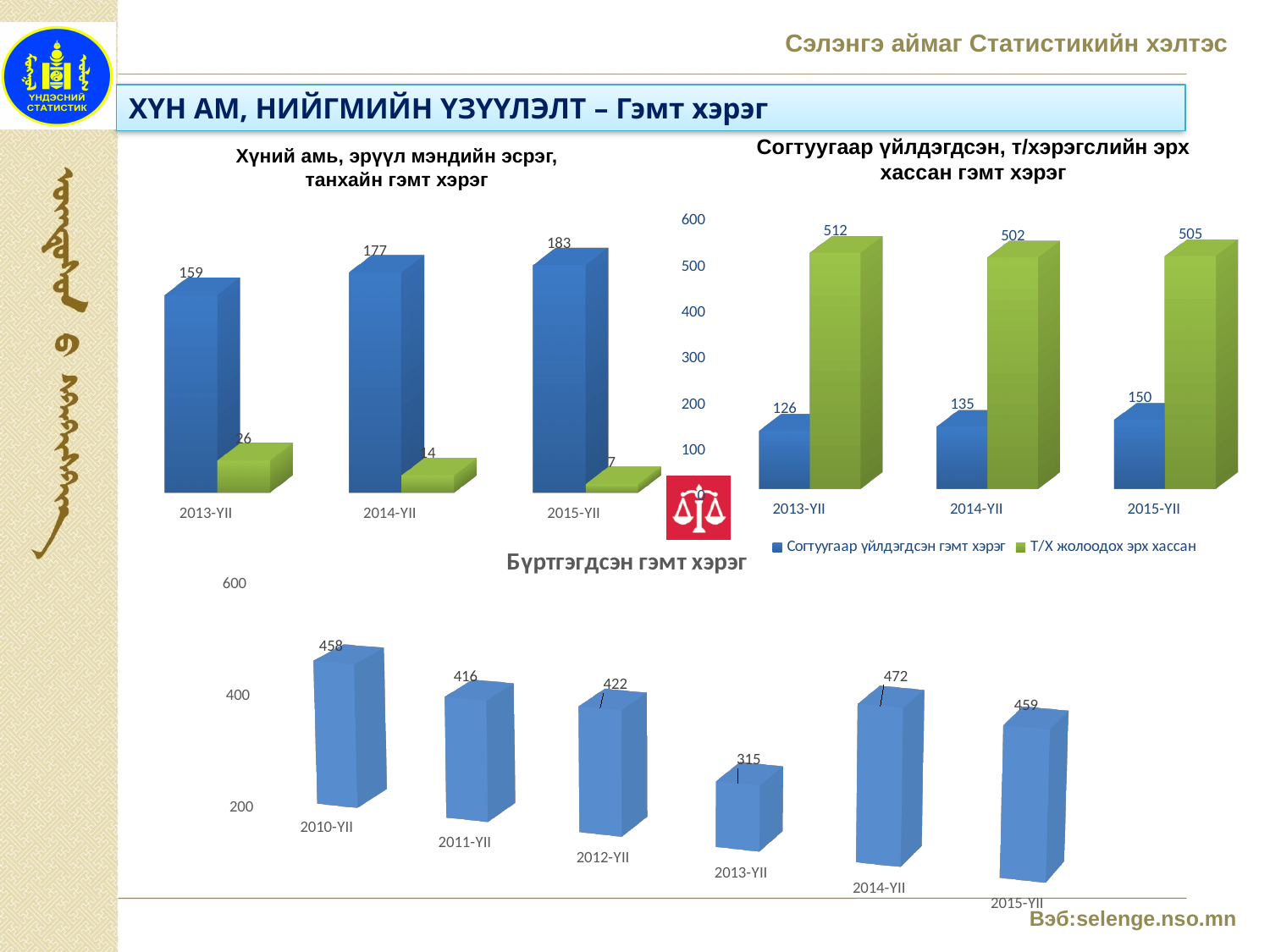
In the chart titled "Хүний амь, эрүүл мэндийн эсрэг, танхайн гэмт хэрэг", what is the value of the green bar for 2015-YII? 7 In the chart titled "Бүртгэгдсэн гэмт хэрэг", how many years are shown on the x axis? 6 In the chart titled "Согтуугаар үйлдэгдсэн, т/хэрэгслийн эрх хассан гэмт хэрэг", what is the value of "Т/Х жолоодох эрх хассан" for 2013-YII? 512 In the chart titled "Бүртгэгдсэн гэмт хэрэг", which year has the lowest value? 2013-YII In the chart titled "Хүний амь, эрүүл мэндийн эсрэг, танхайн гэмт хэрэг", what is the value of the blue bar for 2014-YII? 177 In the chart titled "Бүртгэгдсэн гэмт хэрэг", what is the value for 2013-YII? 315 In the chart titled "Согтуугаар үйлдэгдсэн, т/хэрэгслийн эрх хассан гэмт хэрэг", does the "Согтуугаар үйлдэгдсэн гэмт хэрэг" series rise or fall from 2013-YII to 2015-YII? rise In the chart titled "Согтуугаар үйлдэгдсэн, т/хэрэгслийн эрх хассан гэмт хэрэг", how many series does the legend list? 2 What kind of chart is the one titled "Бүртгэгдсэн гэмт хэрэг"? bar chart In the chart titled "Согтуугаар үйлдэгдсэн, т/хэрэгслийн эрх хассан гэмт хэрэг", what is the value of "Согтуугаар үйлдэгдсэн гэмт хэрэг" for 2015-YII? 150 In the chart titled "Бүртгэгдсэн гэмт хэрэг", what is the difference between the values for 2014-YII and 2013-YII? 157 In the chart titled "Бүртгэгдсэн гэмт хэрэг", which year has the highest value? 2014-YII